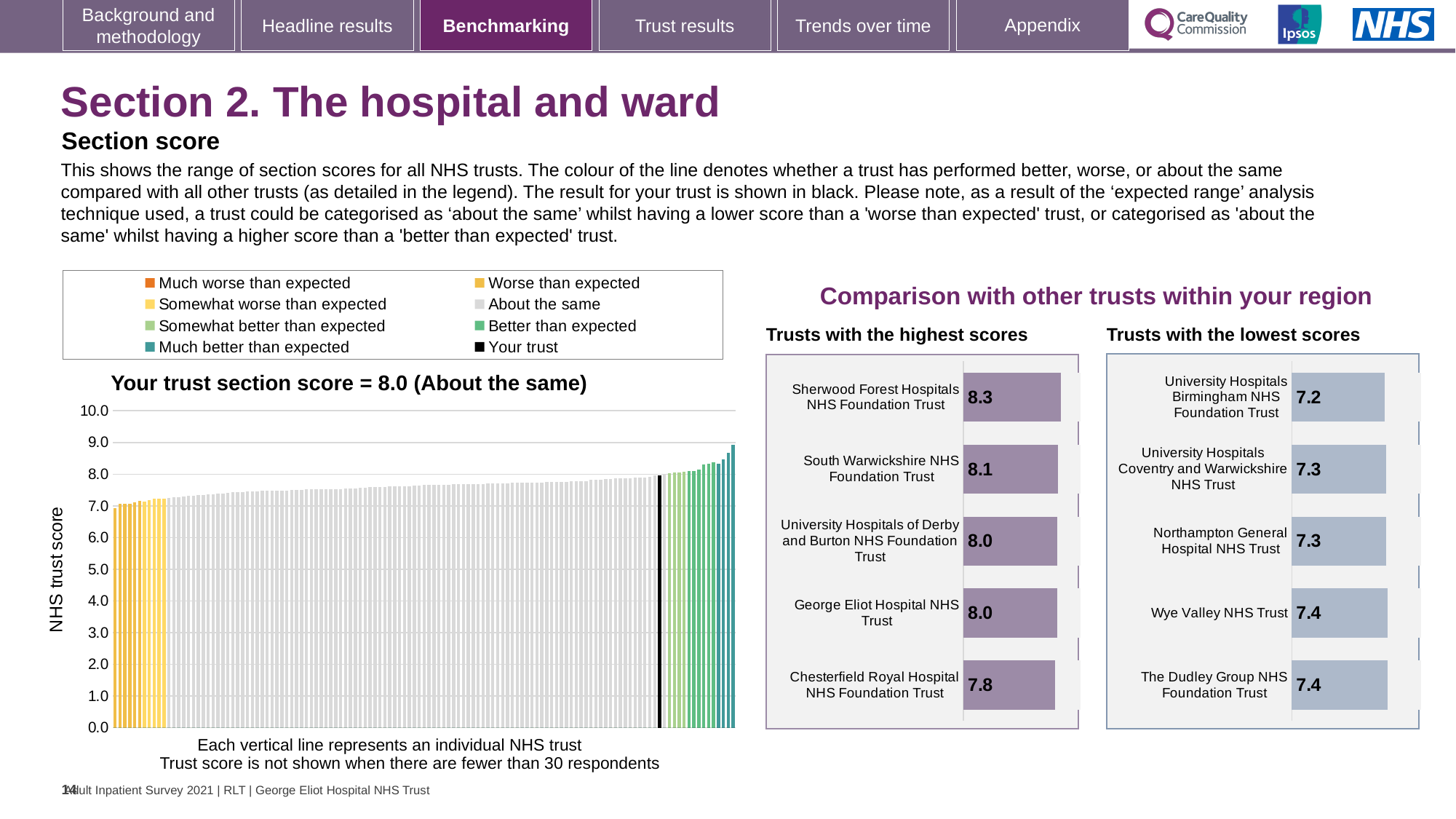
In the 'Trusts with the lowest scores' chart, what is the score for The Dudley Group NHS Foundation Trust? 7.4 What kind of chart is the 'Your trust section score' chart on the left of the slide? Bar chart In the 'Trusts with the lowest scores' chart, which trust has the lowest score? University Hospitals Birmingham NHS Foundation Trust How many entries does the legend above the left-hand chart list? 8 In the 'Trusts with the highest scores' chart, what is the difference between the scores of Sherwood Forest Hospitals NHS Foundation Trust and Chesterfield Royal Hospital NHS Foundation Trust? 0.5 In the 'Trusts with the highest scores' chart, what is the score for Sherwood Forest Hospitals NHS Foundation Trust? 8.3 In the 'Trusts with the lowest scores' chart, what is the difference between the scores of Wye Valley NHS Trust and University Hospitals Birmingham NHS Foundation Trust? 0.2 In the 'Trusts with the highest scores' chart, how many trusts are listed? 5 According to the title of the chart on the left, what is your trust's section score? 8.0 In the 'Trusts with the highest scores' chart, which trust has the lowest score? Chesterfield Royal Hospital NHS Foundation Trust In the 'Trusts with the highest scores' chart, which has the higher score: Sherwood Forest Hospitals NHS Foundation Trust or South Warwickshire NHS Foundation Trust? Sherwood Forest Hospitals NHS Foundation Trust In the 'Trusts with the lowest scores' chart, what is the score for Northampton General Hospital NHS Trust? 7.3